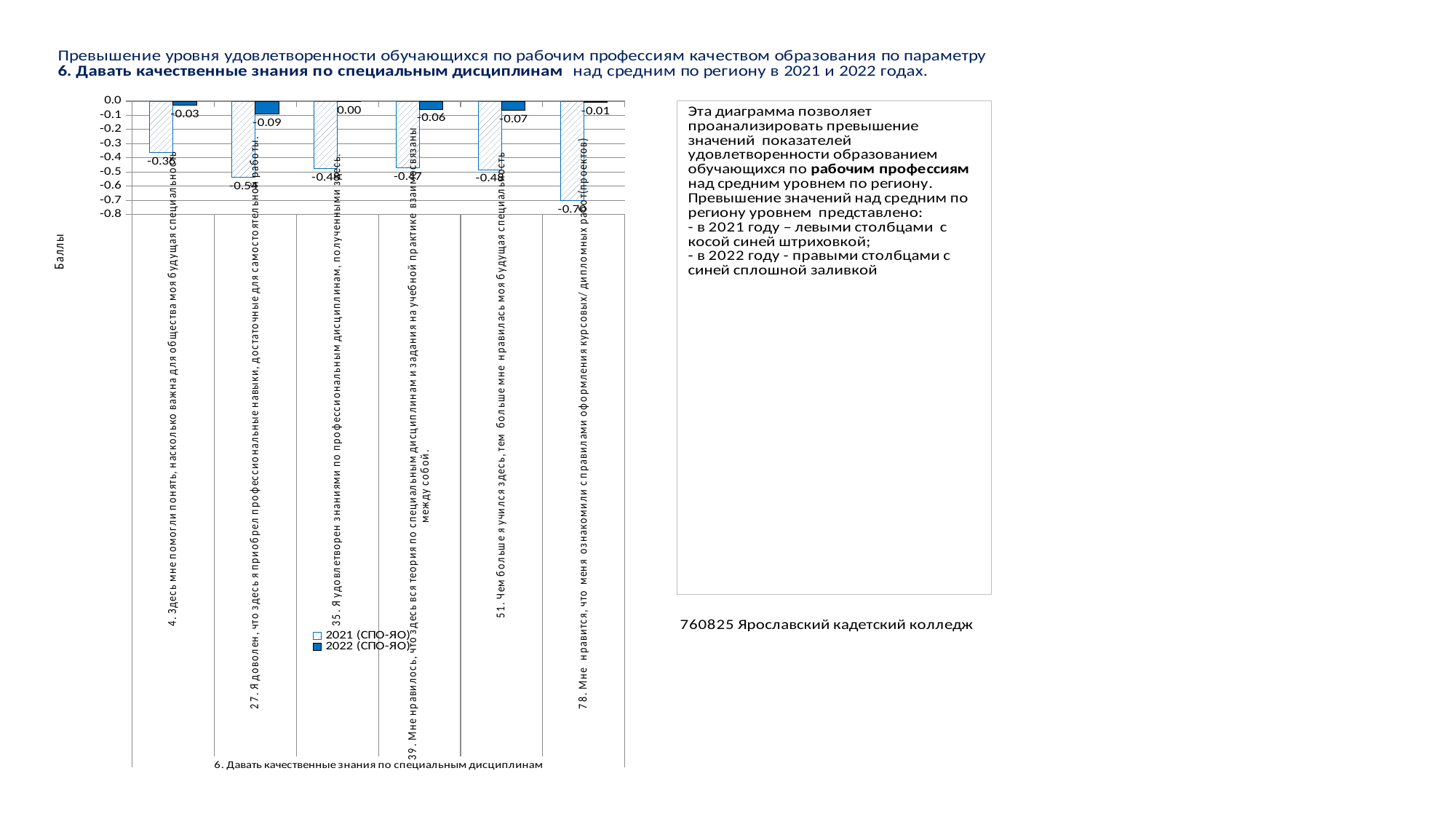
What is the 2022 (СПО-ЯО) value for category 78 (Мне нравится, что меня ознакомили с правилами оформления курсовых/дипломных работ)? -0.01 Which category has the lowest 2021 (СПО-ЯО) value? 78. Мне нравится, что меня ознакомили с правилами оформления курсовых/дипломных работ (проектов) How many series does the chart legend list? 2 Which is larger: the 2022 value for category 4 or the 2022 value for category 27? Category 4 (-0.03) How many categories (questions) are plotted on the x axis of the chart? 6 What is the difference between the 2021 and 2022 values for category 27? 0.45 Is the 2021 (СПО-ЯО) value for category 78 greater or less than -0.6? less What is the 2022 (СПО-ЯО) value for category 27 (Я доволен, что здесь я приобрел профессиональные навыки...)? -0.09 What kind of chart is shown on the slide? Bar chart What is the 2021 (СПО-ЯО) value for category 27 (Я доволен, что здесь я приобрел профессиональные навыки...)? -0.54 What is the 2022 (СПО-ЯО) value for category 35 (Я удовлетворен знаниями по профессиональным дисциплинам...)? 0.00 Which category has the highest 2022 (СПО-ЯО) value? 35. Я удовлетворен знаниями по профессиональным дисциплинам, полученными здесь